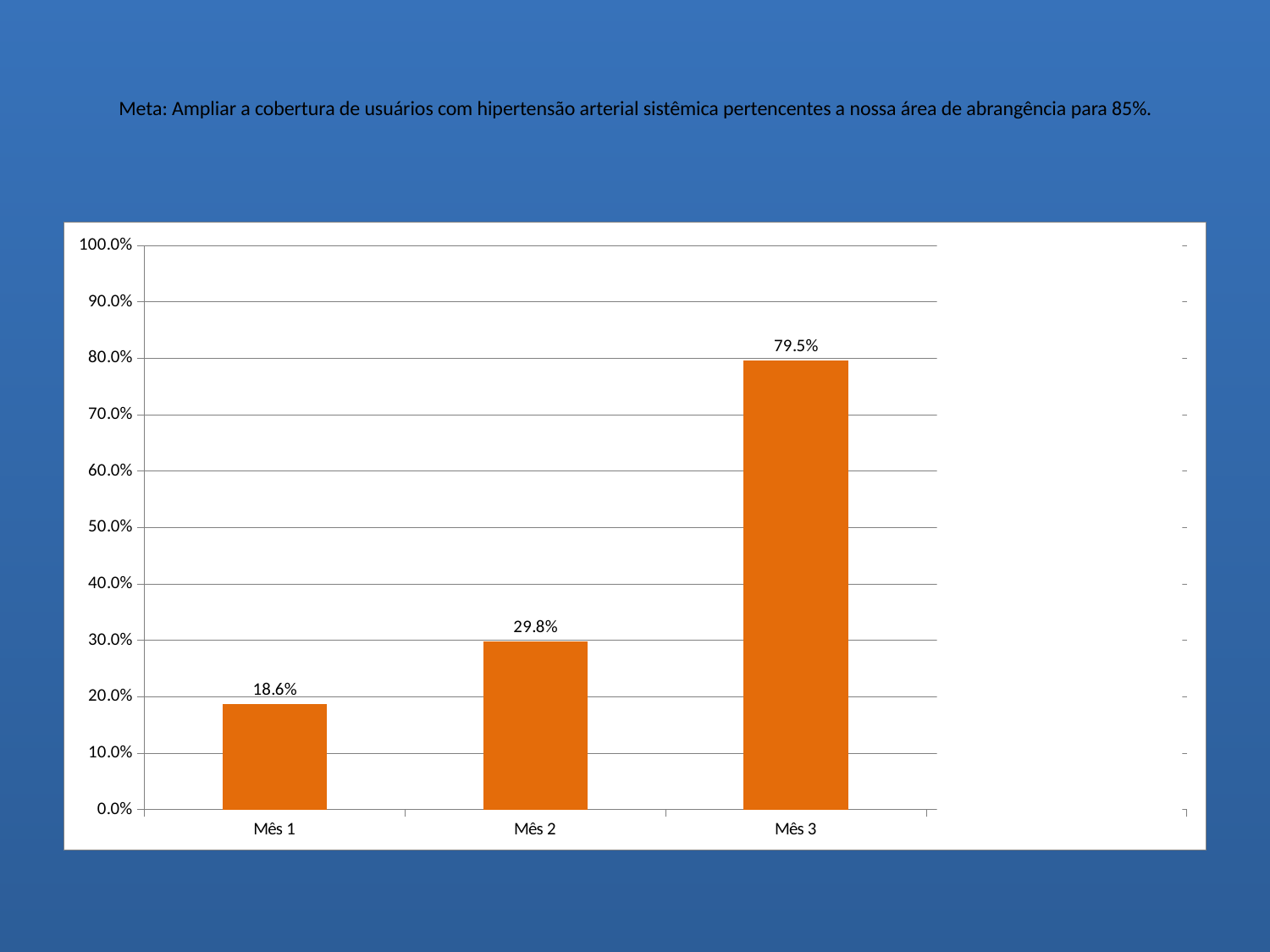
What is the difference between the values for Mês 3 and Mês 2? 49.7% What is the difference between the values for Mês 2 and Mês 1? 11.2% Is the value for Mês 3 greater or less than 70.0%? greater Which month has the lowest value? Mês 1 What is the value for Mês 2? 29.8% What is the value for Mês 1? 18.6% Which is larger, the value for Mês 1 or the value for Mês 2? Mês 2 Which month has the highest value? Mês 3 What kind of chart is shown on the slide? bar chart Do the values rise or fall from Mês 1 to Mês 3? rise What is the value for Mês 3? 79.5% How many categories are shown on the x axis? 3